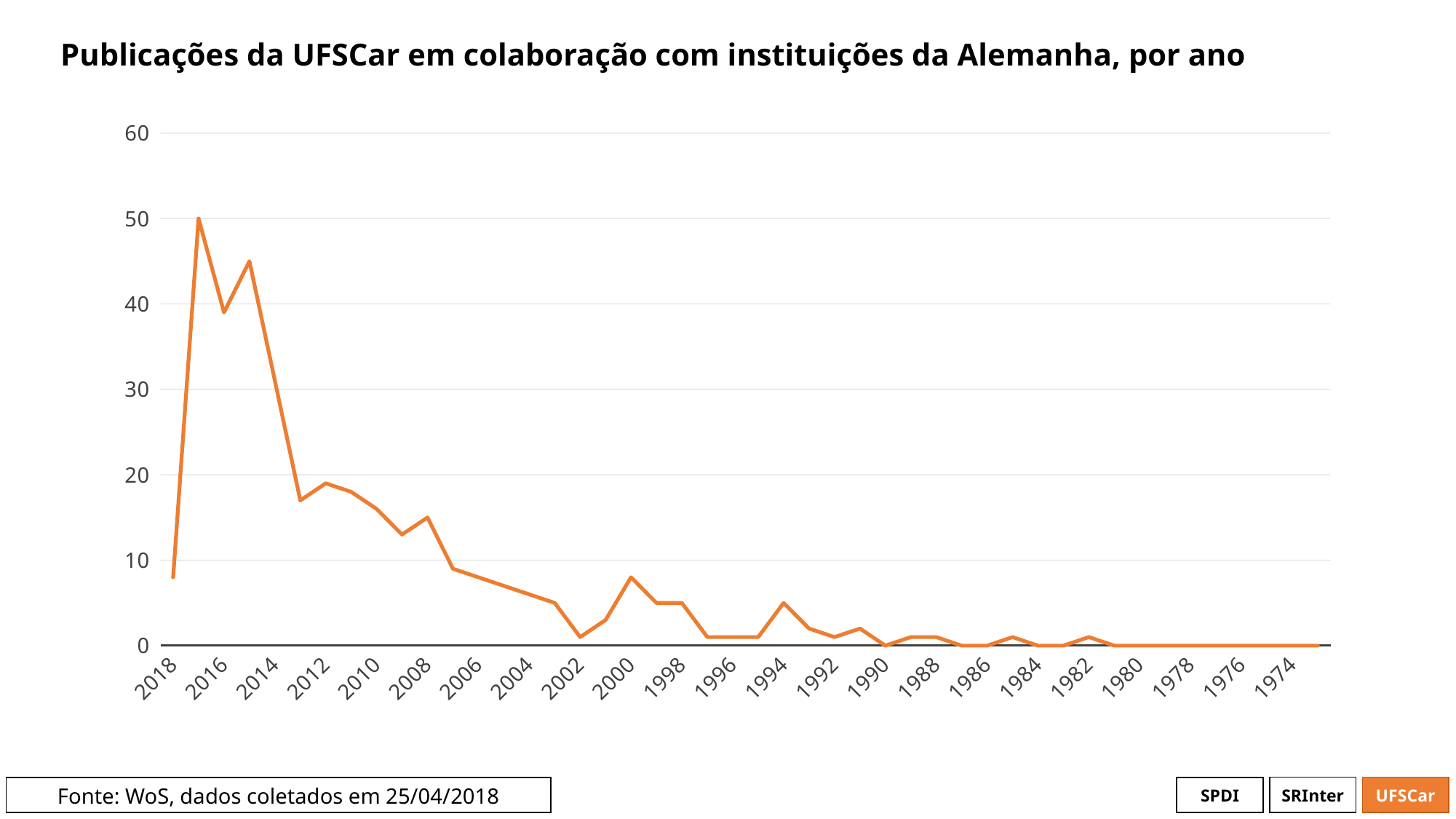
What kind of chart is shown on the slide? line chart Is the value for 2008 greater or less than 10? greater Is the value for 2018 greater or less than 10? less What is the title of the chart? Publicações da UFSCar em colaboração com instituições da Alemanha, por ano Is the value for 2012 greater or less than 10? greater Which is larger, the value for 2016 or the value for 2006? 2016 How many year labels are shown on the x axis? 23 Moving from left (2018) to right (1974) along the x axis, do the values generally rise or fall after the peak near 2016? fall